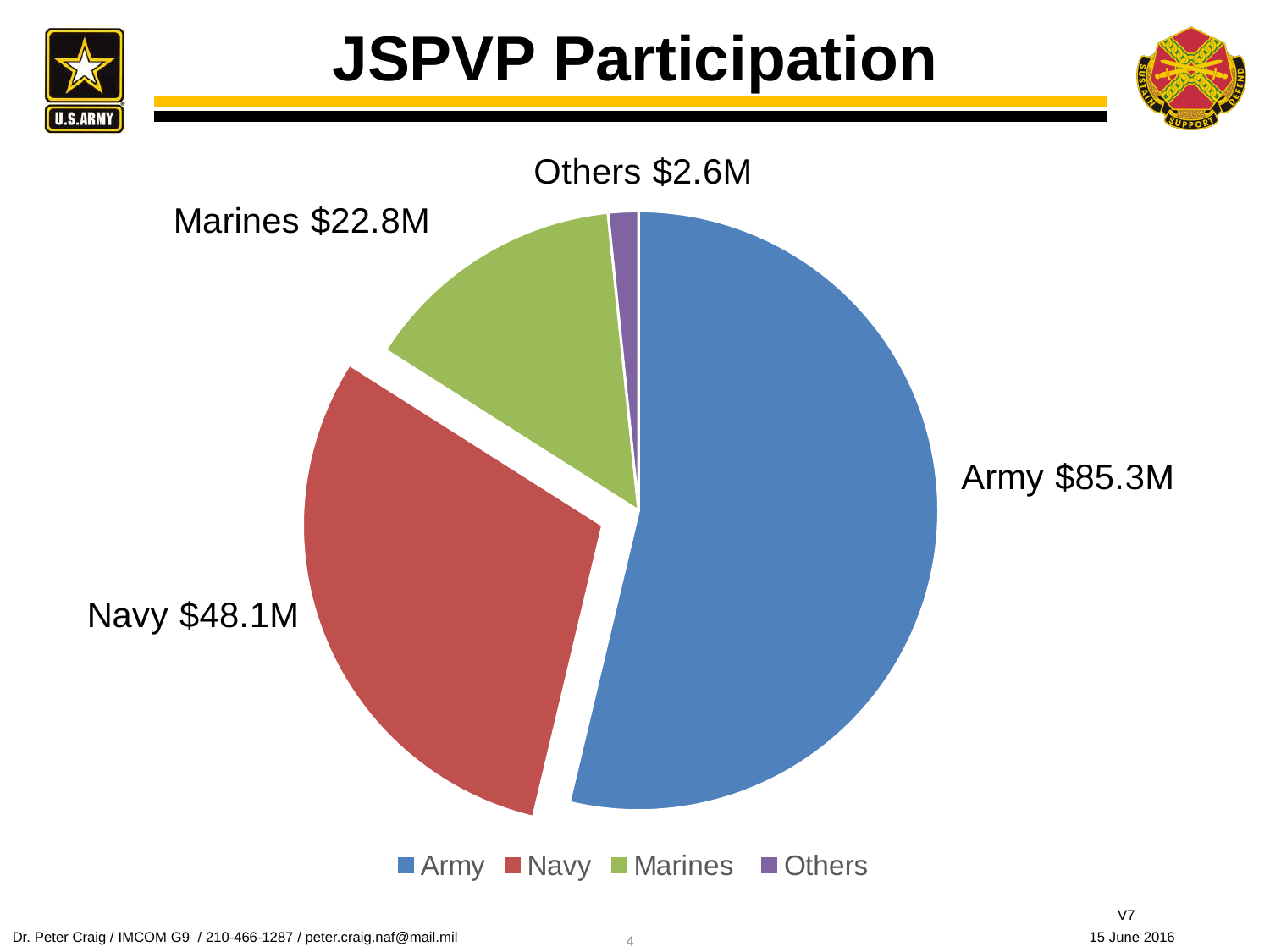
What is the value for Others in the pie chart? $2.6M What is the difference between the Navy and Marines values? $25.3M Which is larger, the value for Marines or the value for Others? Marines How many categories are shown in the pie chart? 4 What is the title of the chart on the slide? JSPVP Participation Which category has the smallest slice of the pie chart? Others What is the value for Army in the pie chart? $85.3M Which category has the largest slice of the pie chart? Army What kind of chart is shown on the slide? Pie chart What is the value for Marines in the pie chart? $22.8M What is the value for Navy in the pie chart? $48.1M What is the difference between the Army and Navy values? $37.2M